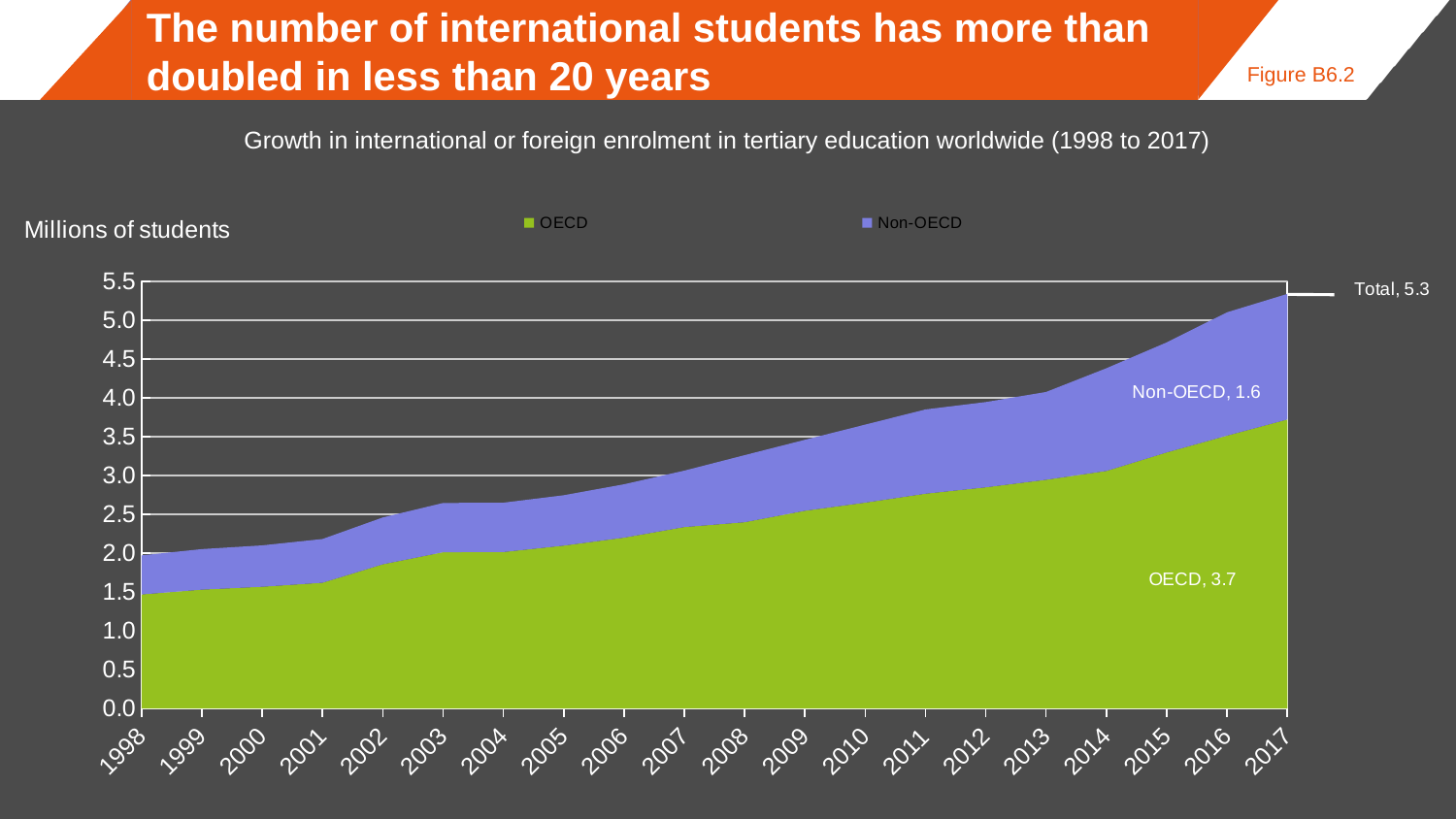
What kind of chart is shown on the slide? Stacked area chart In 2017, how much larger is the OECD value than the Non-OECD value? 2.1 What is the value for OECD in 2017? 3.7 What is the value for Non-OECD in 2017? 1.6 How many years are shown on the x axis? 20 Is the value for OECD in 1998 greater or less than 2.0? less In 2017, which is larger: OECD or Non-OECD? OECD What is the total number of international students (in millions) shown for 2017? 5.3 How many series does the legend list? 2 Is the total (top of the stacked area) in 2010 greater or less than 3.0? greater What unit is given for the y axis? Millions of students Does the total number of international students rise or fall from 1998 to 2017? Rise